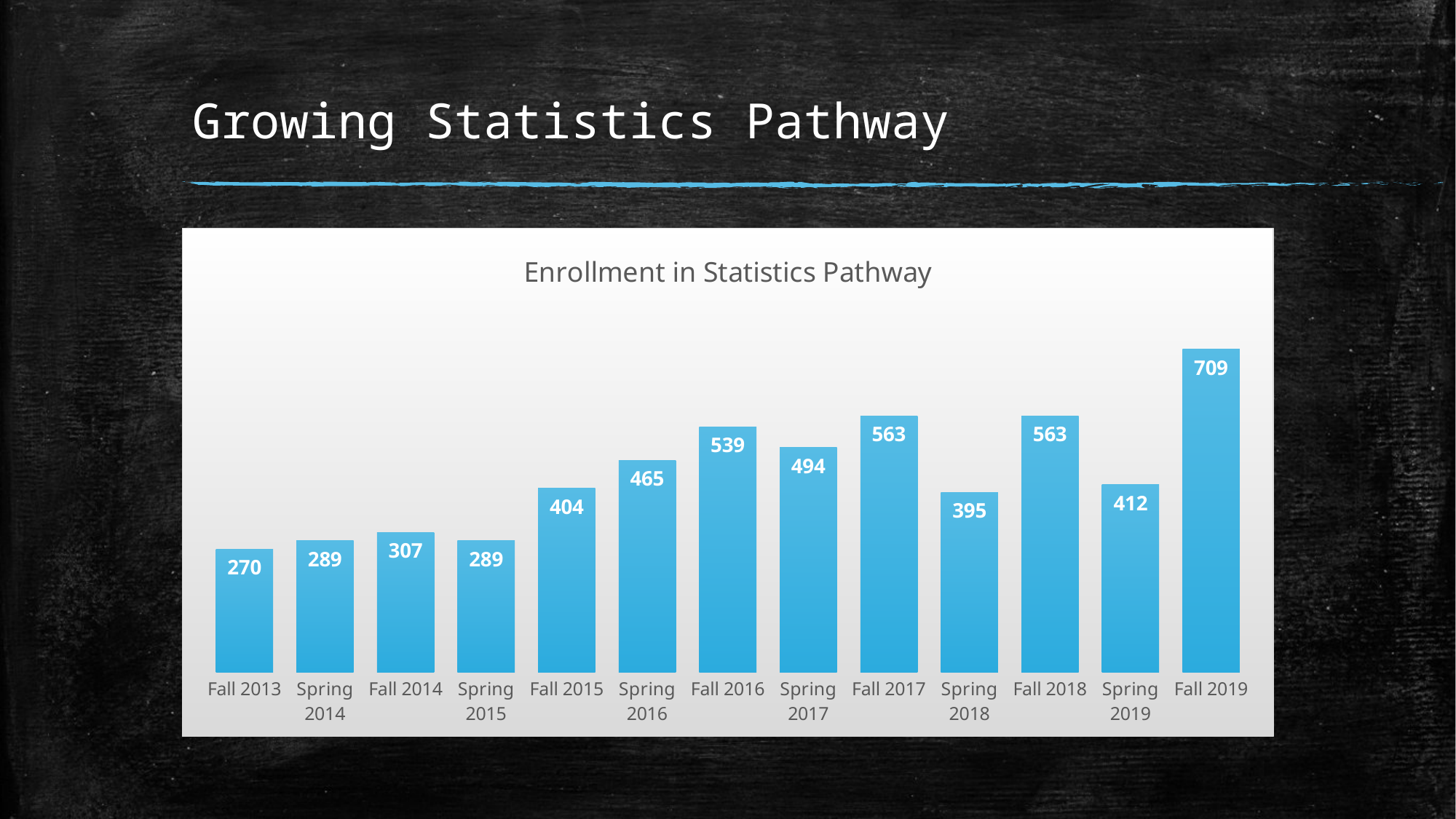
What is the enrollment value for Fall 2019? 709 What is the difference in enrollment between Fall 2016 and Spring 2016? 74 Do the Fall enrollment values generally rise or fall from Fall 2013 to Fall 2019? Rise What is the difference in enrollment between Fall 2019 and Fall 2018? 146 Which term has the lowest enrollment? Fall 2013 What is the enrollment value for Spring 2018? 395 What is the title of the chart? Enrollment in Statistics Pathway What kind of chart is shown on the slide? Bar chart Which is larger, the enrollment for Spring 2017 or Spring 2019? Spring 2017 How many terms are shown on the chart? 13 What is the enrollment value for Fall 2015? 404 Which term has the highest enrollment? Fall 2019